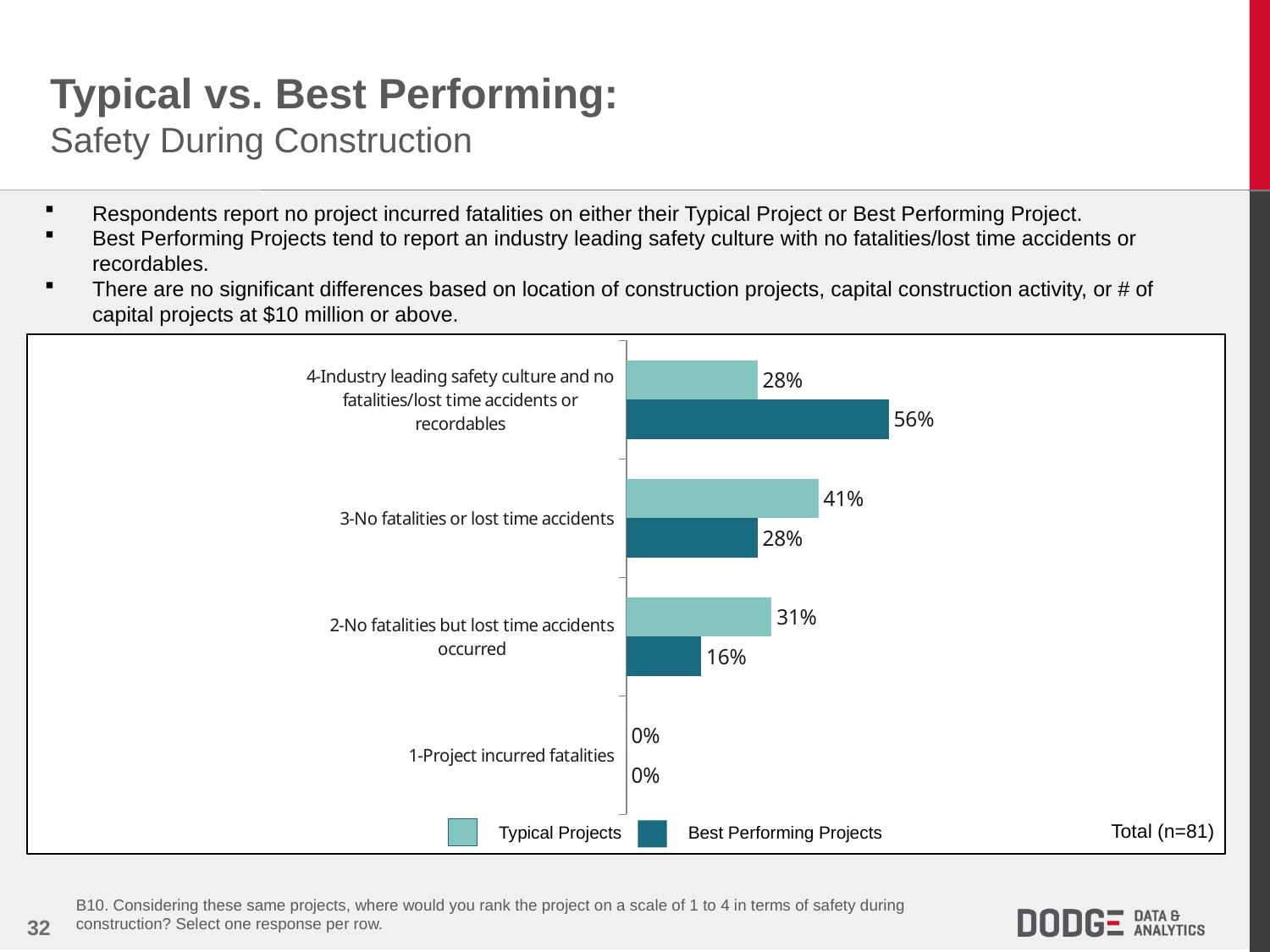
What percentage of Best Performing Projects are rated '4-Industry leading safety culture and no fatalities/lost time accidents or recordables'? 56% What kind of chart is shown on the slide? Bar chart What percentage of Best Performing Projects are rated '2-No fatalities but lost time accidents occurred'? 16% How many series does the legend list? 2 Which category has the highest value for Typical Projects? 3-No fatalities or lost time accidents Which category has the highest value for Best Performing Projects? 4-Industry leading safety culture and no fatalities/lost time accidents or recordables For '2-No fatalities but lost time accidents occurred', which series has the larger value, Typical Projects or Best Performing Projects? Typical Projects What percentage of Typical Projects are rated '3-No fatalities or lost time accidents'? 41% What percentage of Typical Projects are rated '4-Industry leading safety culture and no fatalities/lost time accidents or recordables'? 28% Which category has the lowest value for both series? 1-Project incurred fatalities What is the difference between Best Performing Projects and Typical Projects for the '4-Industry leading safety culture' category? 28% How many categories are shown on the chart? 4